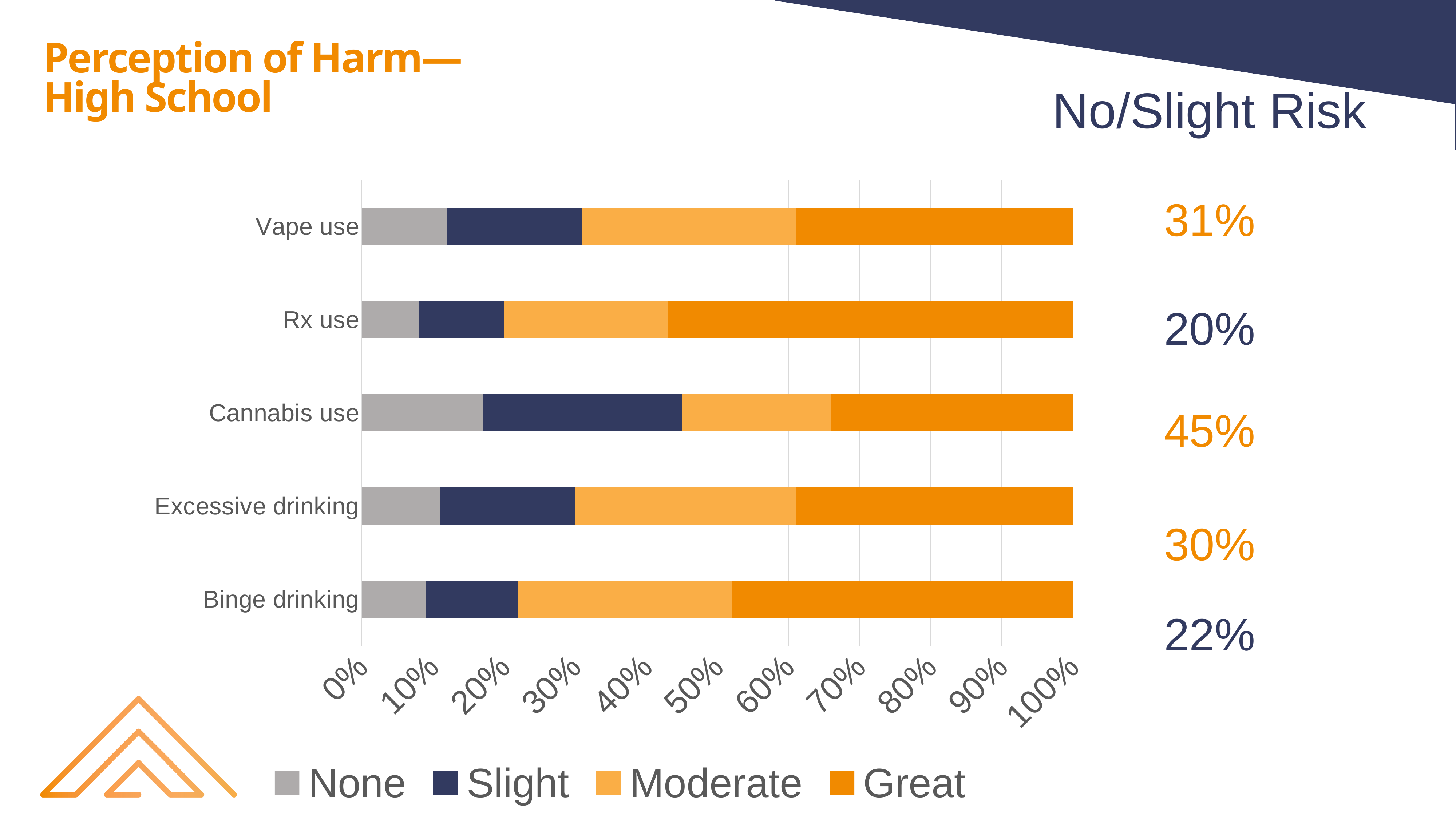
Is the Great segment for Cannabis use greater or less than 40%? less Which category has the highest No/Slight Risk percentage? Cannabis use Which category has the lowest No/Slight Risk percentage? Rx use What is the No/Slight Risk percentage shown for Rx use? 20% Which category has the largest Great segment? Rx use How many categories are plotted on the chart? 5 What is the No/Slight Risk percentage shown for Cannabis use? 45% What kind of chart is shown on the slide? stacked bar chart How many series does the legend list? 4 What are the four series listed in the legend? None, Slight, Moderate, Great What is the No/Slight Risk percentage shown for Vape use? 31% Which category has the largest Slight segment? Cannabis use